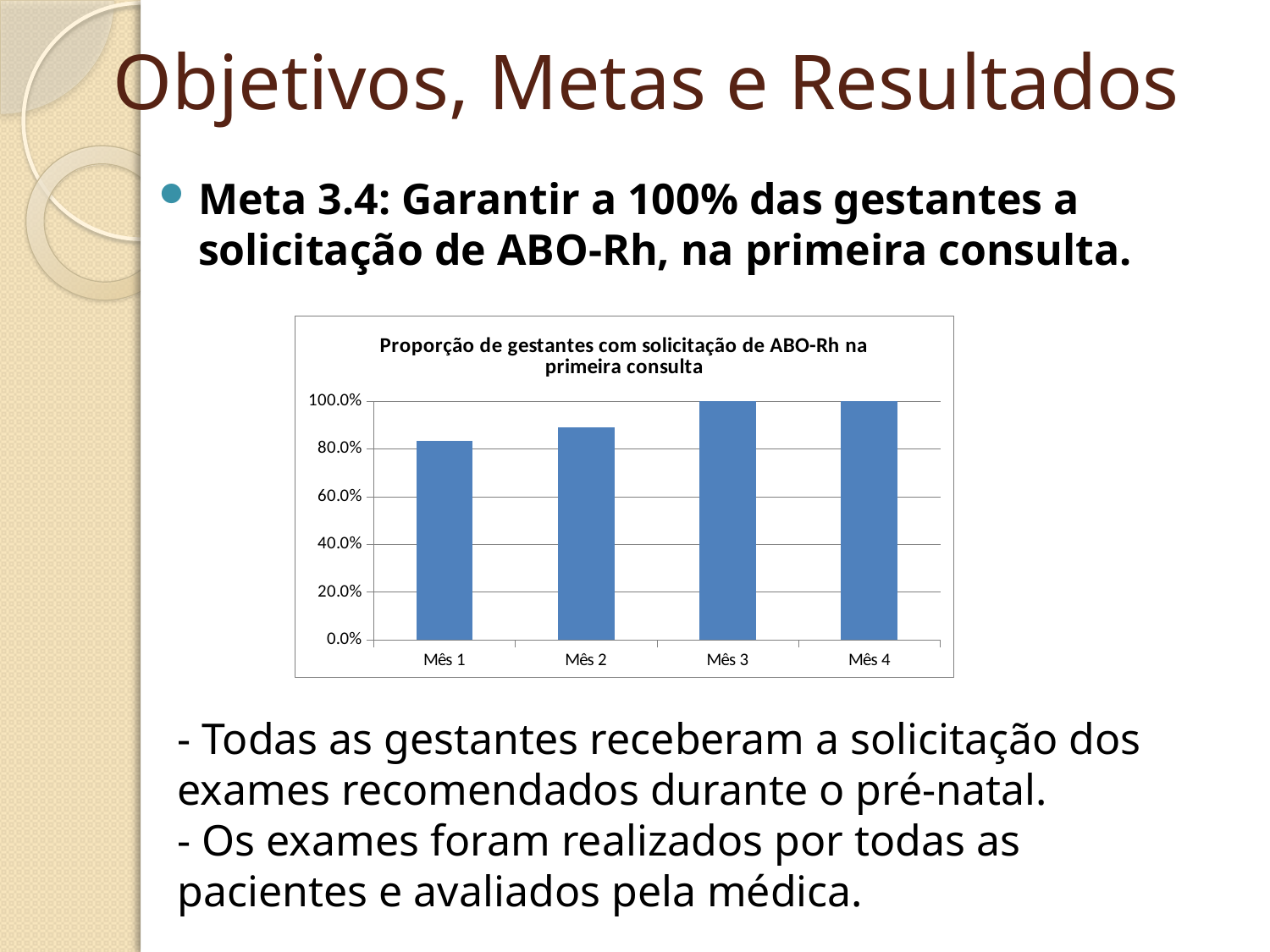
What is the highest value shown on the vertical axis of the chart? 100.0% Which is larger, the value for Mês 1 or the value for Mês 2? Mês 2 What is the title of the chart? Proporção de gestantes com solicitação de ABO-Rh na primeira consulta Is the value for Mês 2 greater or less than 80.0%? greater Is the value for Mês 1 greater or less than 60.0%? greater What is the value for Mês 3? 100.0% Do the values rise or fall from Mês 1 to Mês 4? rise What is the value for Mês 4? 100.0% Is the value for Mês 1 greater or less than 100.0%? less How many months (categories) are plotted in the chart? 4 Which month has the lowest proportion? Mês 1 What kind of chart is shown on the slide? bar chart